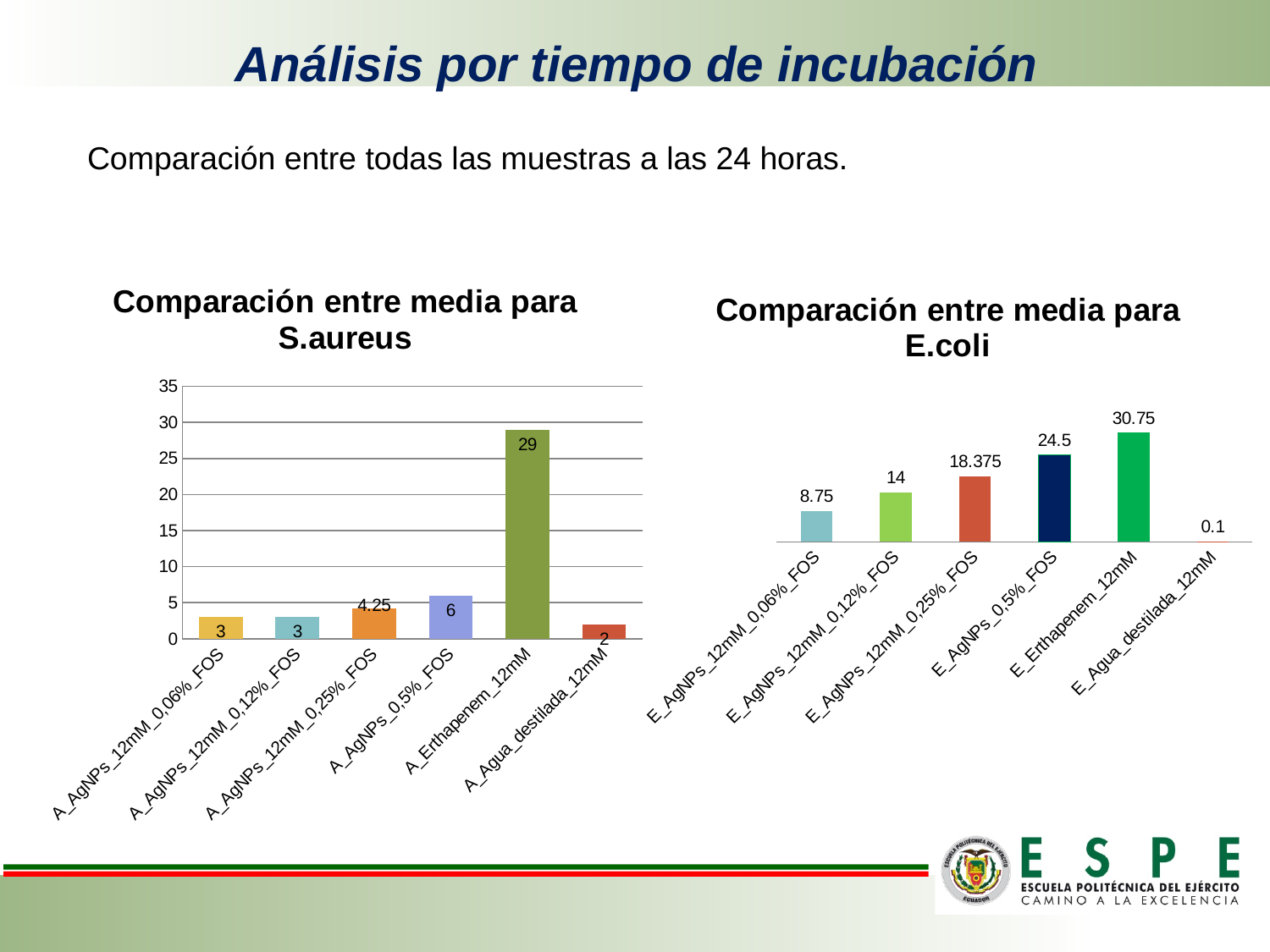
In the 'Comparación entre media para E.coli' chart, which category has the lowest value? E_Agua_destilada_12mM In the 'Comparación entre media para S.aureus' chart, what is the difference between A_Erthapenem_12mM and A_AgNPs_0,5%_FOS? 23 In the 'Comparación entre media para S.aureus' chart, what is the value for A_Erthapenem_12mM? 29 In the 'Comparación entre media para E.coli' chart, what is the value for E_AgNPs_12mM_0,25%_FOS? 18.375 In the 'Comparación entre media para E.coli' chart, what is the value for E_Agua_destilada_12mM? 0.1 How many categories are shown in the 'Comparación entre media para E.coli' chart? 6 In the 'Comparación entre media para E.coli' chart, which is larger: E_AgNPs_12mM_0,12%_FOS or E_AgNPs_12mM_0,06%_FOS? E_AgNPs_12mM_0,12%_FOS In the 'Comparación entre media para E.coli' chart, what is the difference between E_Erthapenem_12mM and E_AgNPs_0,5%_FOS? 6.25 What type of chart is 'Comparación entre media para S.aureus'? Bar chart In the 'Comparación entre media para S.aureus' chart, what is the value for A_AgNPs_12mM_0,25%_FOS? 4.25 In the 'Comparación entre media para S.aureus' chart, which category has the highest value? A_Erthapenem_12mM In the 'Comparación entre media para S.aureus' chart, is the value for A_Erthapenem_12mM greater or less than 25? greater